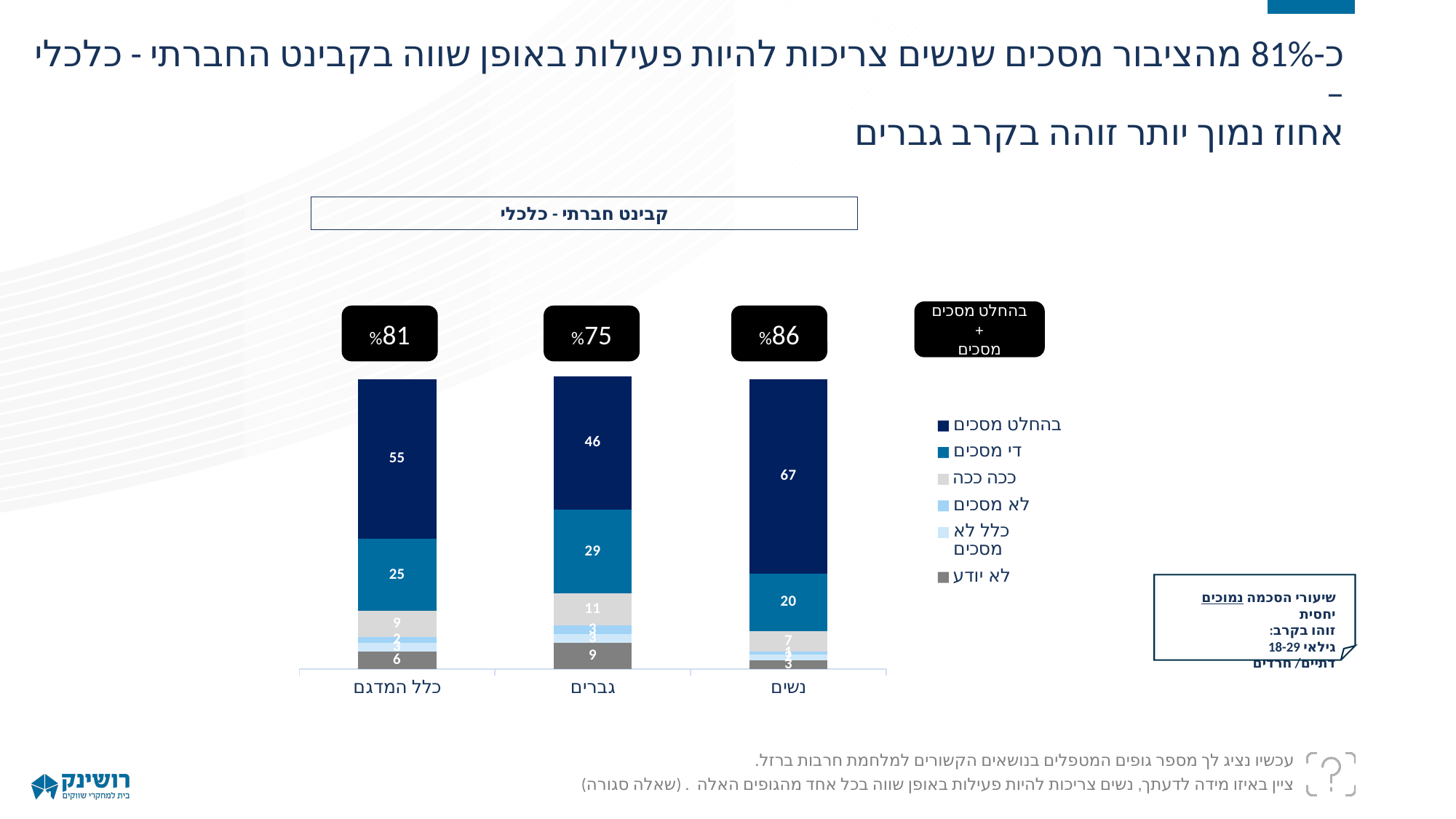
What is the value of די מסכים for גברים? 29 Which category has the lowest combined percentage shown above its bar? גברים How many categories are shown on the x axis of the chart? 3 What is the value of בהחלט מסכים for כלל המדגם? 55 How many series does the chart legend list? 6 What is the value of בהחלט מסכים for נשים? 67 Which category has the highest value for בהחלט מסכים? נשים What is the difference between the בהחלט מסכים values for נשים and גברים? 21 What is the value of לא יודע for גברים? 9 What combined percentage (בהחלט מסכים + מסכים) is shown above the גברים bar? 75% Which is larger: the ככה ככה value for גברים or for נשים? גברים What type of chart is shown on the slide? stacked bar chart